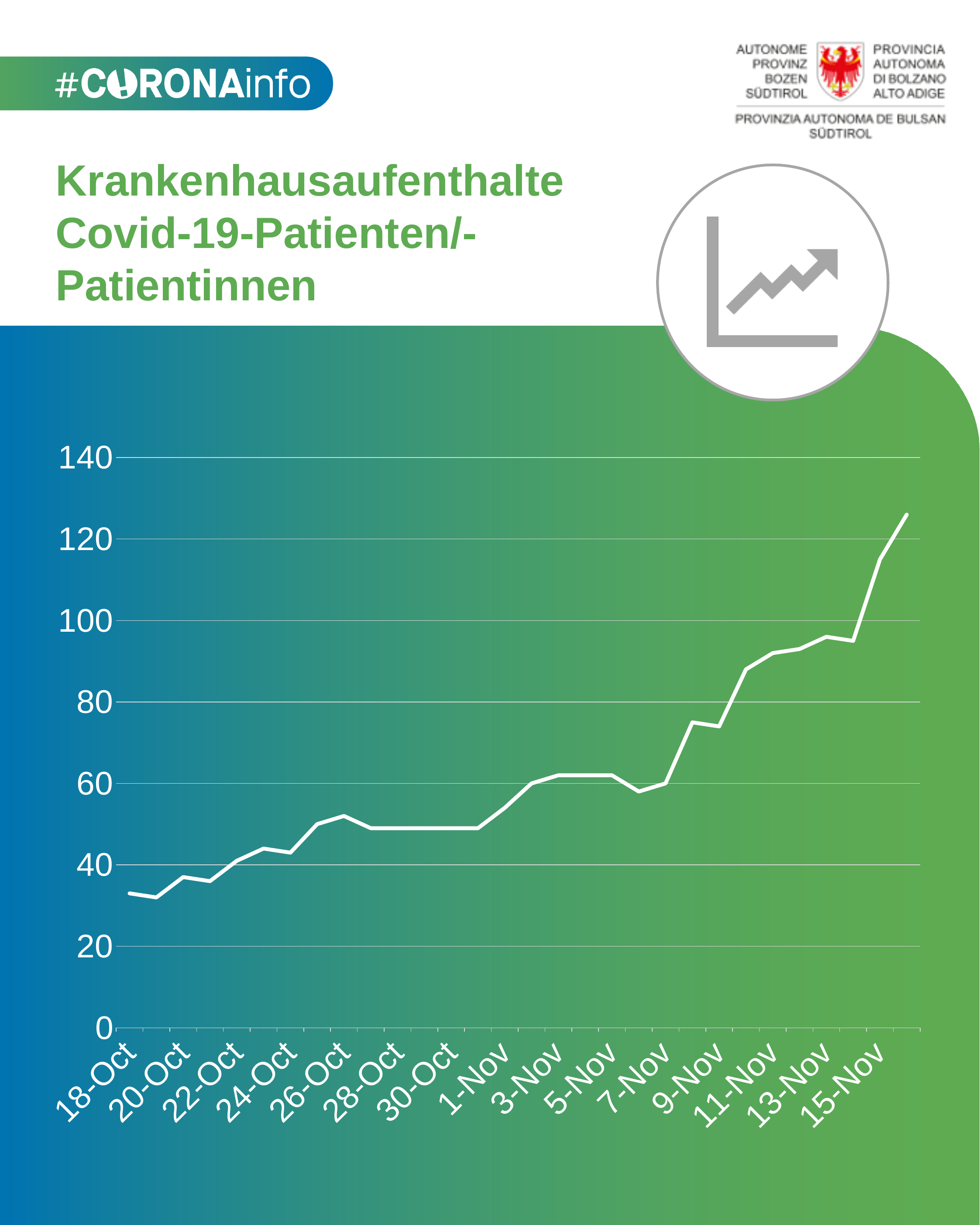
Which is larger, the value for 9-Nov or the value for 18-Oct? 9-Nov What is the title of the chart on the slide? Krankenhausaufenthalte Covid-19-Patienten/-Patientinnen What is the highest value shown on the vertical axis? 140 Is the value for 11-Nov greater or less than 80? greater Is the value for 1-Nov greater or less than 60? less Do the values generally rise or fall from 18-Oct to the end of the series? rise Is the value for 13-Nov greater or less than 100? less What kind of chart is shown on the slide? line chart